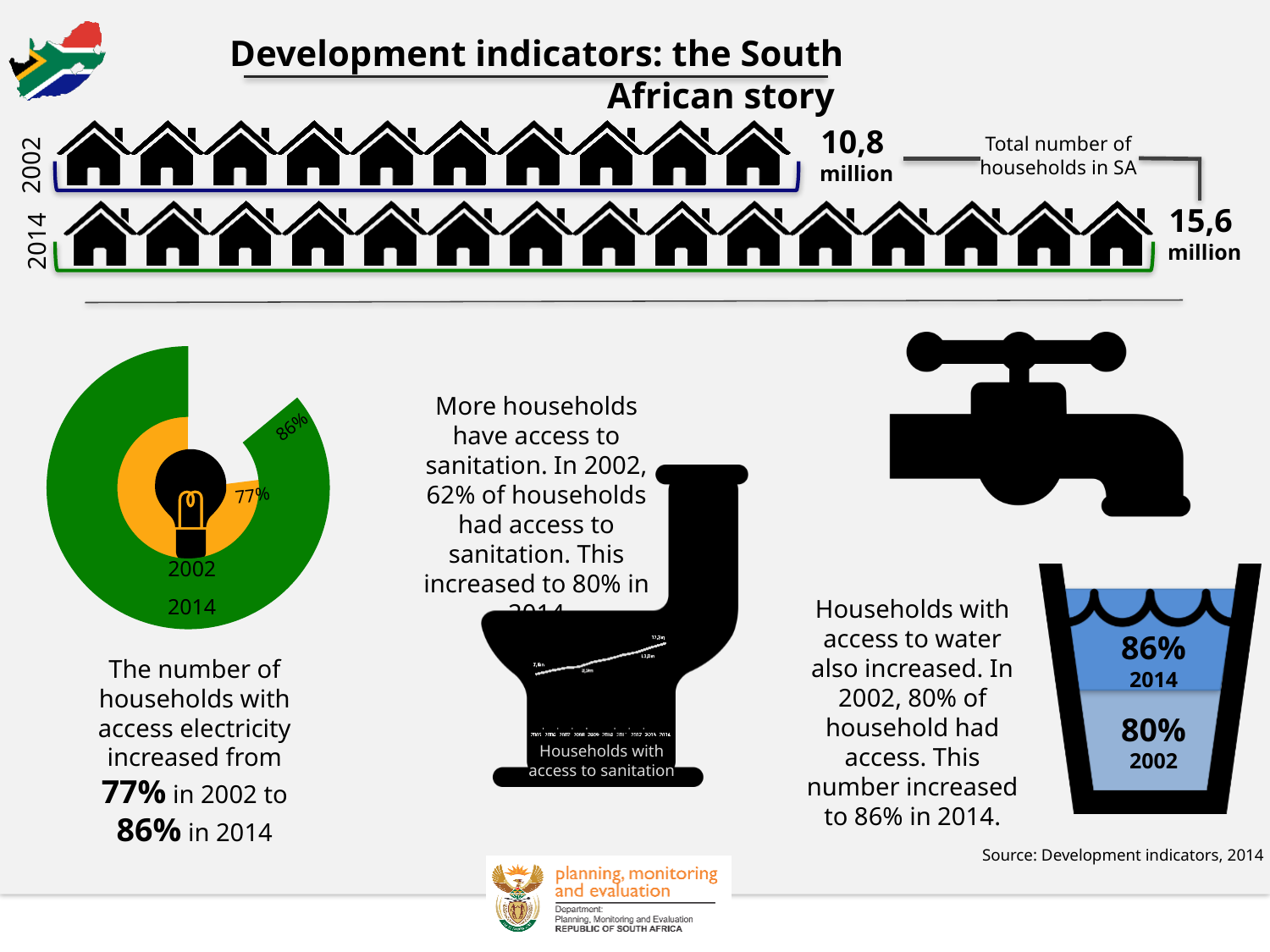
According to the house icons at the top of the slide, what was the total number of households in SA in 2014? 15,6 million What kind of chart is used on the left of the slide to show household access to electricity? Donut (pie) chart In the donut chart on the left of the slide, what percentage of households had access to electricity in 2002? 77% In the water glass graphic on the right of the slide, what percentage of households had access to water in 2002? 80% What is the title of the chart inside the toilet graphic in the middle of the slide? Households with access to sanitation How many years are shown in the donut chart on the left of the slide? 2 In the donut chart on the left of the slide, by how many percentage points did household access to electricity increase from 2002 to 2014? 9 percentage points In the donut chart on the left of the slide, which year has the higher value, 2002 or 2014? 2014 In the water glass graphic on the right of the slide, what percentage of households had access to water in 2014? 86% In the donut chart on the left of the slide, what percentage of households had access to electricity in 2014? 86% In the line chart inside the toilet graphic, do the values rise or fall over time? Rise What kind of chart is shown inside the toilet graphic in the middle of the slide? Line chart